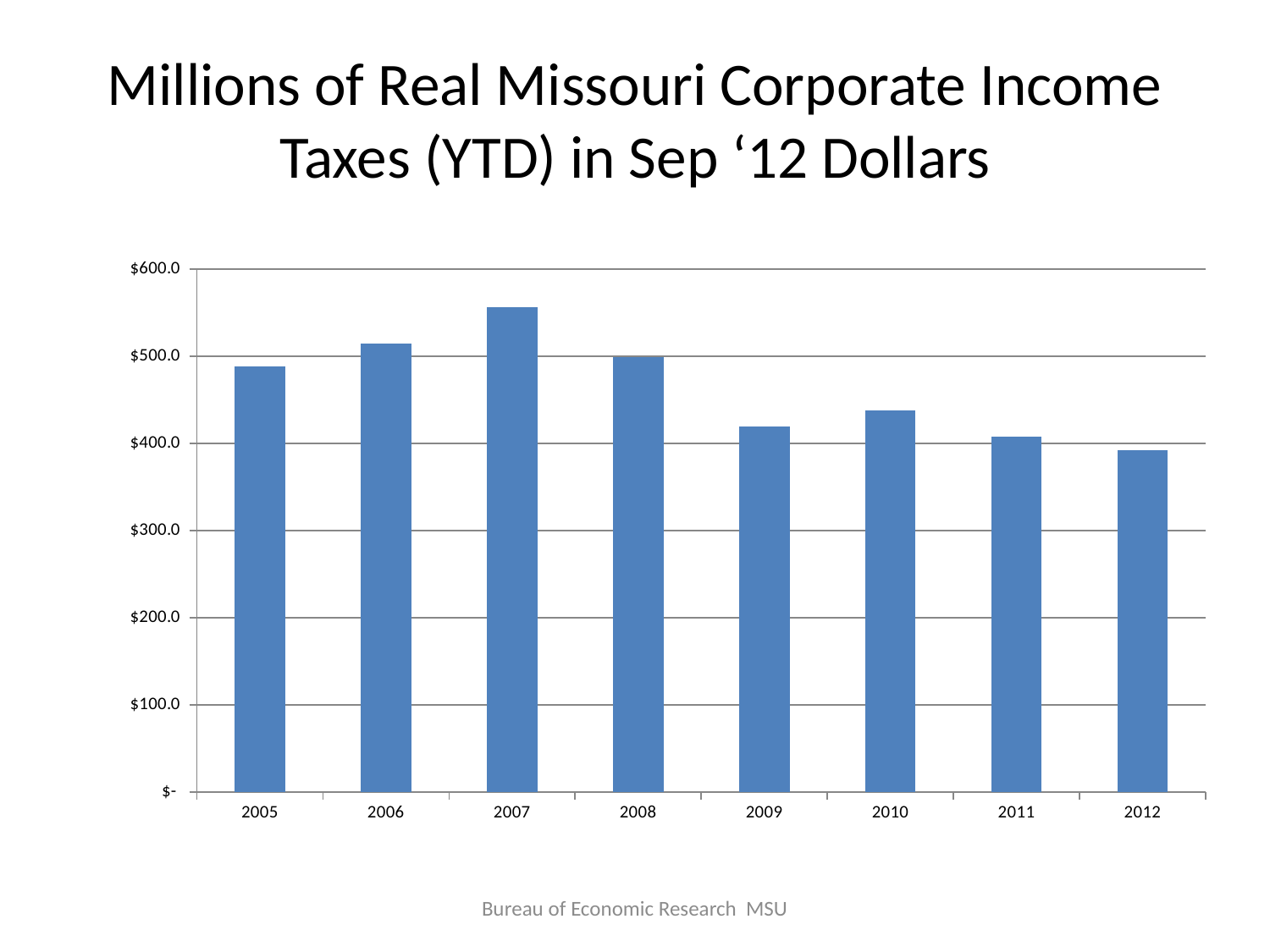
Is the value for 2007 greater or less than $500.0? greater What kind of chart is shown on the slide? Bar chart Is the value for 2012 greater or less than $400.0? less Which year has the larger value, 2006 or 2009? 2006 Which year has the larger value, 2010 or 2011? 2010 Is the value for 2005 greater or less than $500.0? less Which year has the highest value in the chart? 2007 Do the values rise or fall from 2007 to 2012? fall How many years are shown on the x axis of the chart? 8 What is the title of the chart on the slide? Millions of Real Missouri Corporate Income Taxes (YTD) in Sep '12 Dollars Which year has the lowest value in the chart? 2012